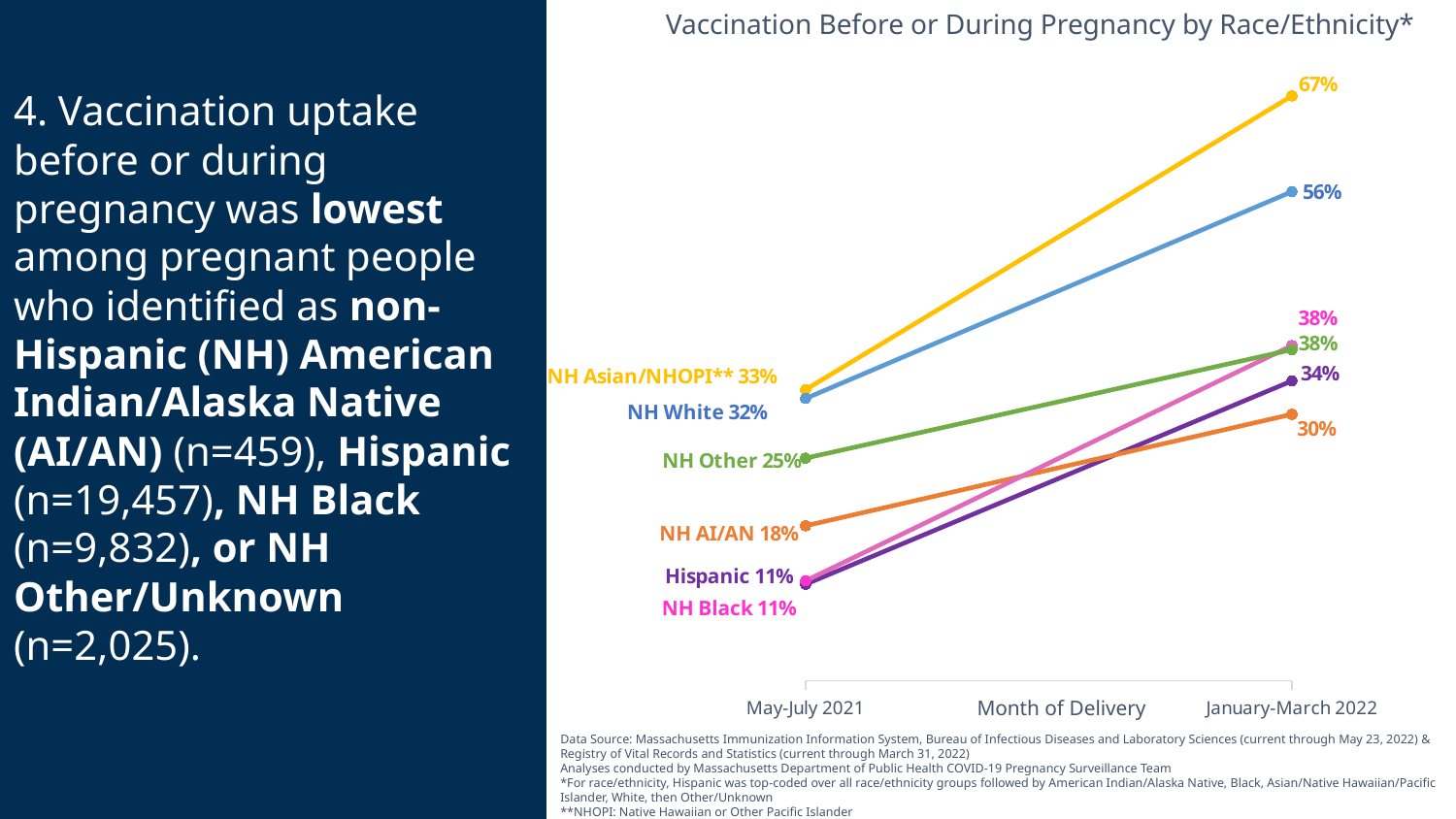
What was the vaccination percentage for NH Other in January-March 2022? 38% Do the vaccination percentages rise or fall from May-July 2021 to January-March 2022? rise What was the vaccination percentage for NH AI/AN in May-July 2021? 18% How much did the vaccination percentage for NH Asian/NHOPI increase from May-July 2021 to January-March 2022? 34 percentage points Which race/ethnicity group had the lowest vaccination percentage in January-March 2022? NH AI/AN Which race/ethnicity group had the highest vaccination percentage in January-March 2022? NH Asian/NHOPI What type of chart is shown on the slide? line chart What is the title of the chart? Vaccination Before or During Pregnancy by Race/Ethnicity* Which group had a higher vaccination percentage in January-March 2022, Hispanic or NH AI/AN? Hispanic What was the vaccination percentage for NH Asian/NHOPI in May-July 2021? 33% How many race/ethnicity groups are plotted on the chart? 6 What was the vaccination percentage for NH White in January-March 2022? 56%